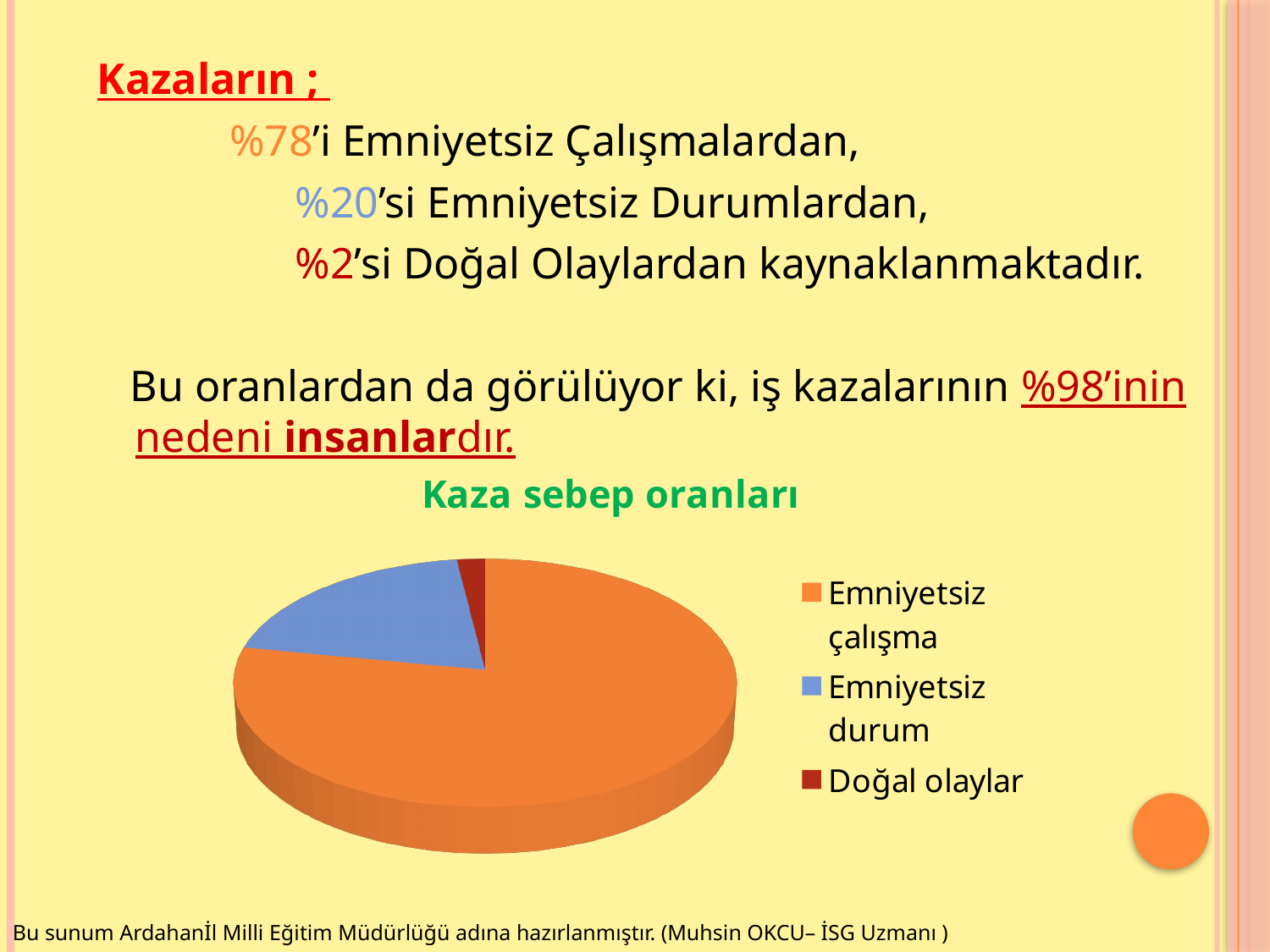
According to the slide, what share of accidents is due to Emniyetsiz çalışma? %78 How many slices does the pie chart have? 3 Which category has the smallest slice of the pie? Doğal olaylar Which slice is larger, Emniyetsiz çalışma or Emniyetsiz durum? Emniyetsiz çalışma Which slice is larger, Emniyetsiz durum or Doğal olaylar? Emniyetsiz durum According to the slide, what share of accidents is due to Emniyetsiz durum? %20 What is the title of the chart? Kaza sebep oranları How many entries does the chart legend list? 3 Which category has the largest slice of the pie? Emniyetsiz çalışma What kind of chart is shown on the slide? pie chart According to the slide, what share of accidents is due to Doğal olaylar? %2 What colour is the Emniyetsiz durum slice in the pie chart? blue